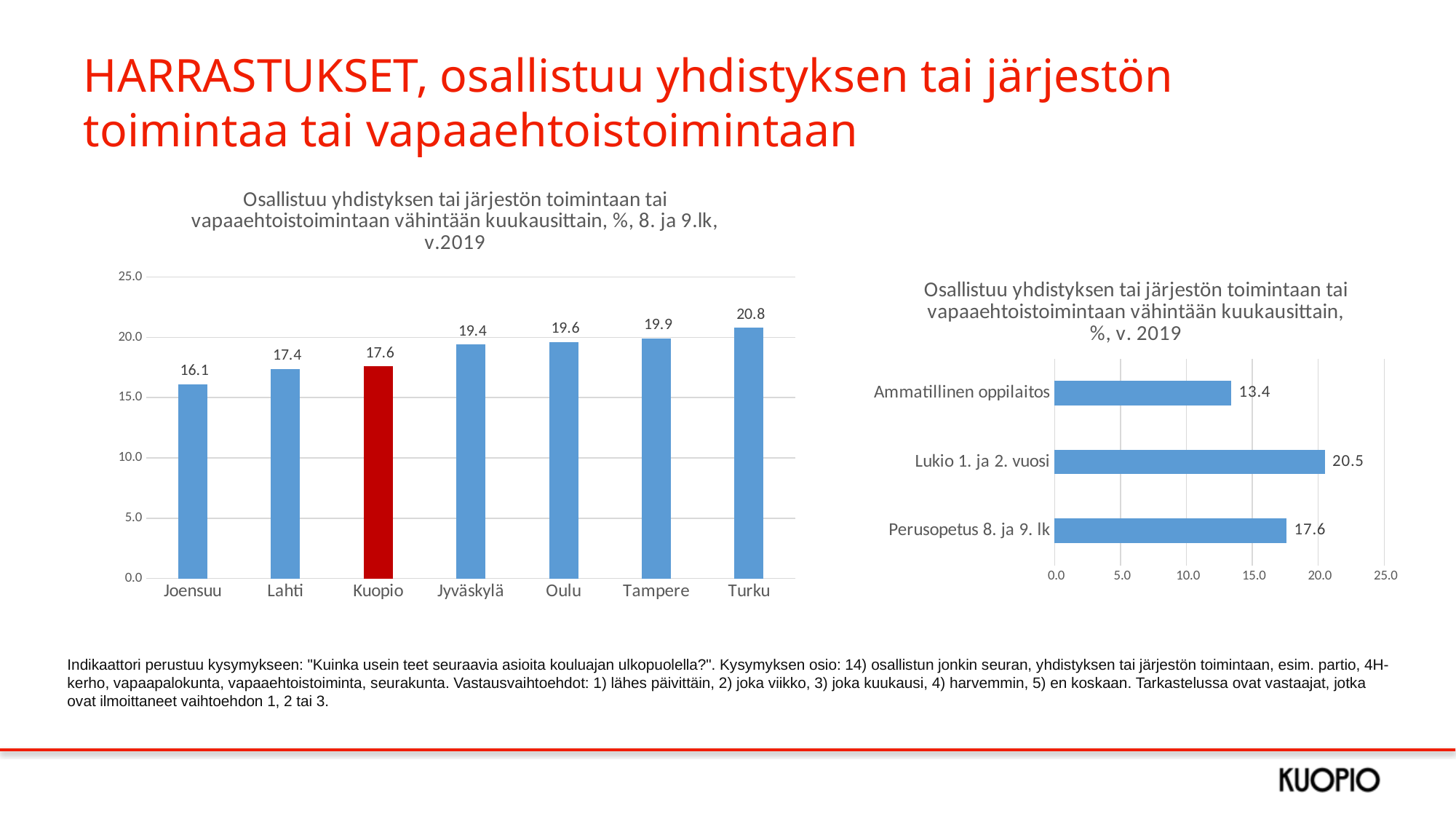
In the right chart (by school level), what is the difference between Lukio 1. ja 2. vuosi and Ammatillinen oppilaitos? 7.1 In the left chart (8. ja 9.lk by city), what is the value for Tampere? 19.9 In the left chart (8. ja 9.lk by city), how many cities are shown? 7 In the right chart (by school level), which category has the lowest value? Ammatillinen oppilaitos In the left chart (8. ja 9.lk by city), which city has the lowest value? Joensuu What kind of chart is the right chart (by school level)? Bar chart In the left chart (8. ja 9.lk by city), which city has the highest value? Turku In the left chart (8. ja 9.lk by city), which is larger, the value for Lahti or the value for Oulu? Oulu In the left chart (8. ja 9.lk by city), what is the difference between Turku and Joensuu? 4.7 In the right chart (by school level), what is the value for Lukio 1. ja 2. vuosi? 20.5 In the left chart (8. ja 9.lk by city), which bar is coloured red instead of blue? Kuopio In the left chart (8. ja 9.lk by city), what is the value for Kuopio? 17.6